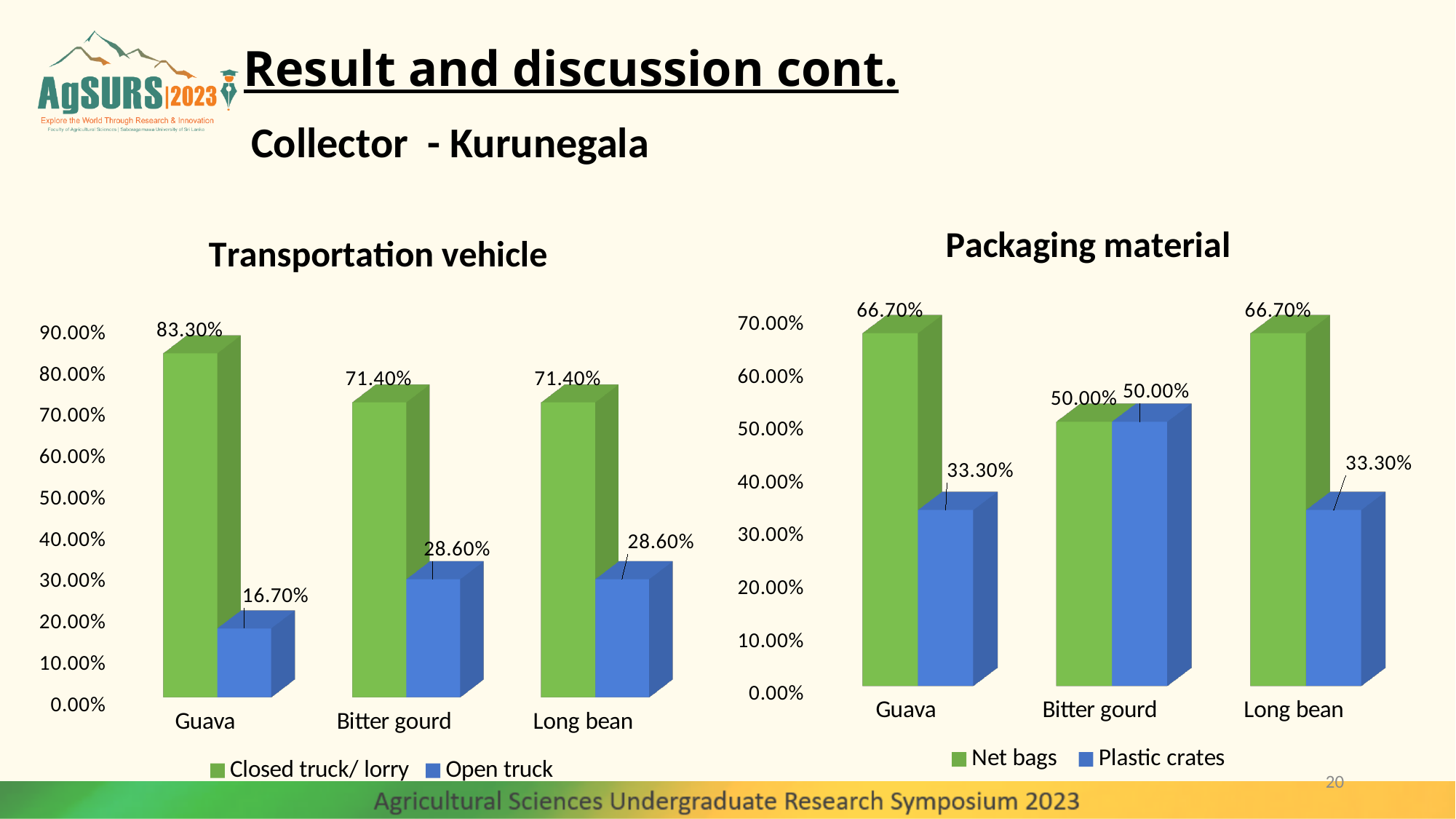
In the Transportation vehicle chart, what is the value for Closed truck/ lorry for Guava? 83.30% In the Transportation vehicle chart, which category has the lowest Open truck value? Guava What kind of chart is the Packaging material chart? Bar chart In the Packaging material chart, what is the difference between Net bags and Plastic crates for Long bean? 33.40% How many series does the legend of the Transportation vehicle chart list? 2 In the Packaging material chart, what is the value for Plastic crates for Long bean? 33.30% In the Transportation vehicle chart, what is the value for Open truck for Bitter gourd? 28.60% In the Transportation vehicle chart, which category has the highest Closed truck/ lorry value? Guava In the Packaging material chart, which is larger for Guava: Net bags or Plastic crates? Net bags How many categories are shown on the x axis of the Packaging material chart? 3 In the Packaging material chart, what is the value for Net bags for Bitter gourd? 50.00% In the Transportation vehicle chart, what is the difference between the Closed truck/ lorry and Open truck values for Guava? 66.60%